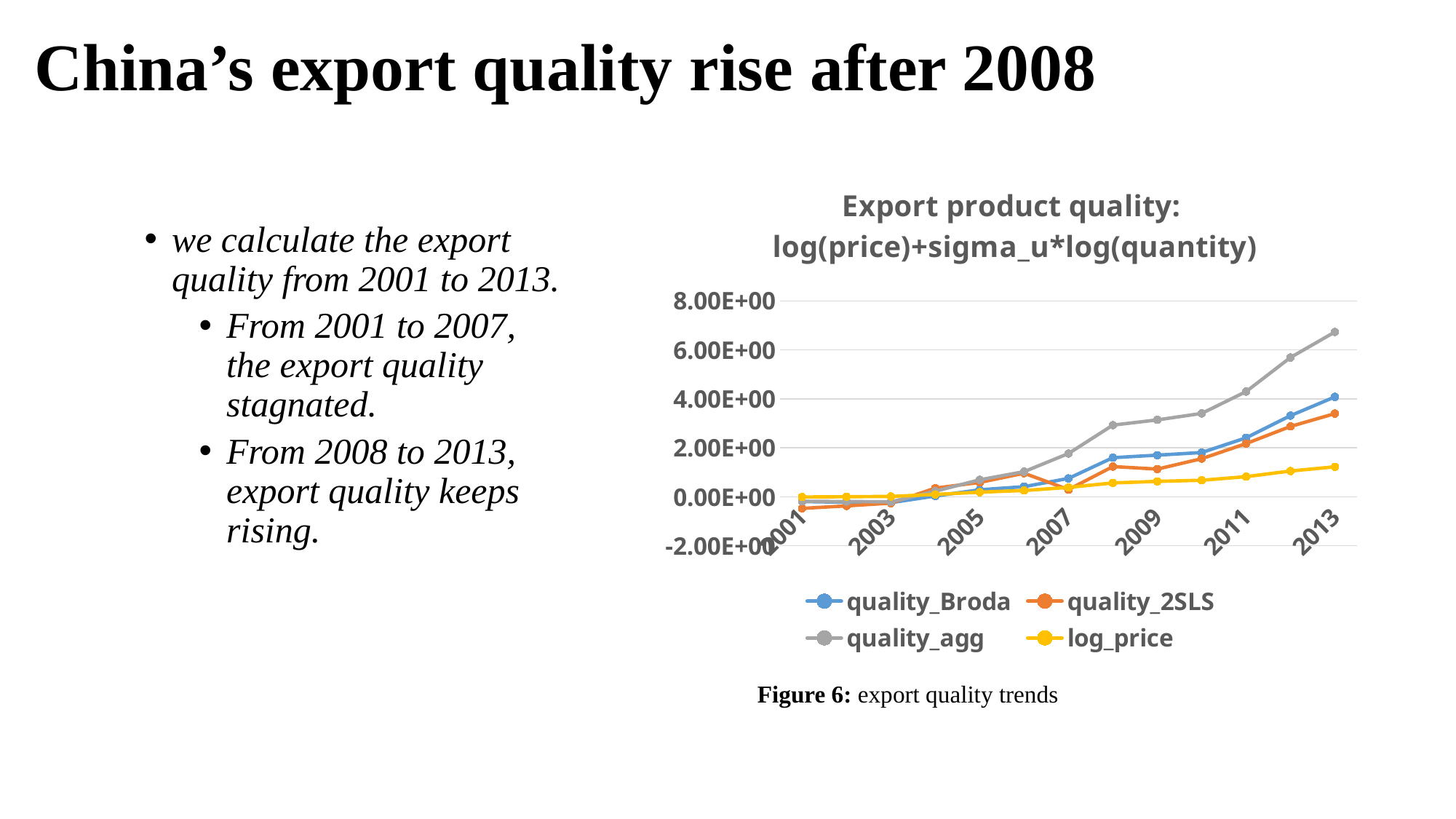
Is the value of quality_agg in 2008 greater or less than 2.00E+00? greater Is the value of log_price in 2013 greater or less than 2.00E+00? less In 2013, which is larger: quality_Broda or quality_2SLS? quality_Broda Which series is drawn in grey in the chart? quality_agg Is the value of quality_agg in 2013 greater or less than 6.00E+00? greater What kind of chart is shown on the slide? line chart Does the quality_agg series rise or fall from 2008 to 2013? rise How many years are plotted along the x axis of the chart? 13 Which series has the lowest value in 2013? log_price Which series has the highest value in 2013? quality_agg What is the title of the chart? Export product quality: log(price)+sigma_u*log(quantity) How many series does the legend of the chart list? 4